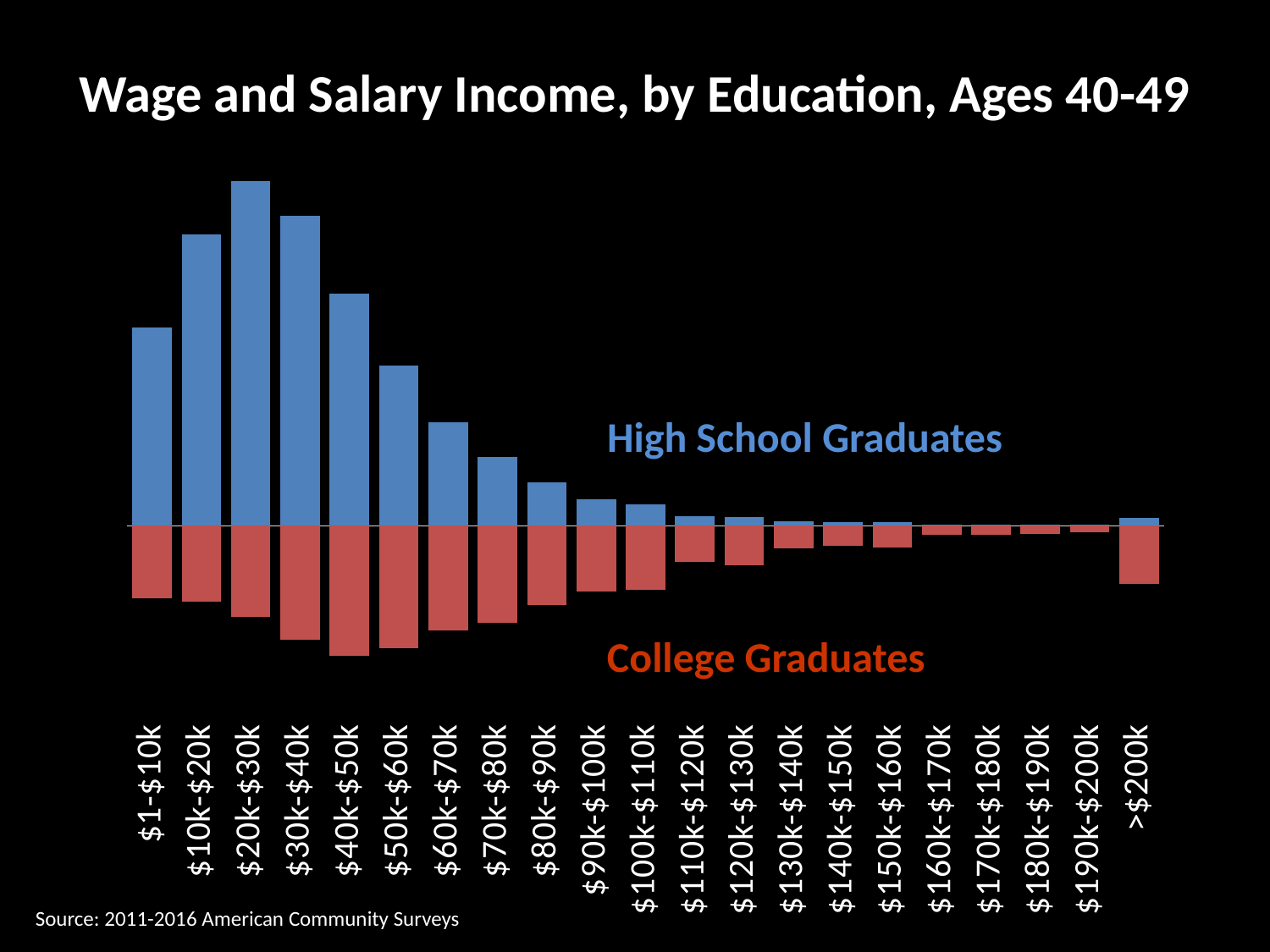
What is the title of the chart? Wage and Salary Income, by Education, Ages 40-49 For High School Graduates, which bar is larger: $40k-$50k or $50k-$60k? $40k-$50k For College Graduates, which bar is larger: $190k-$200k or >$200k? >$200k How many data series does the chart show? 2 Do the High School Graduates bars rise or fall from $20k-$30k to $190k-$200k? fall For High School Graduates, which bar is larger: $1-$10k or $10k-$20k? $10k-$20k Which income category has the tallest bar for High School Graduates? $20k-$30k Which income category has the largest bar for College Graduates? $40k-$50k Which colour represents College Graduates? red How many income categories are shown along the x axis? 21 What kind of chart is shown on the slide? bar chart